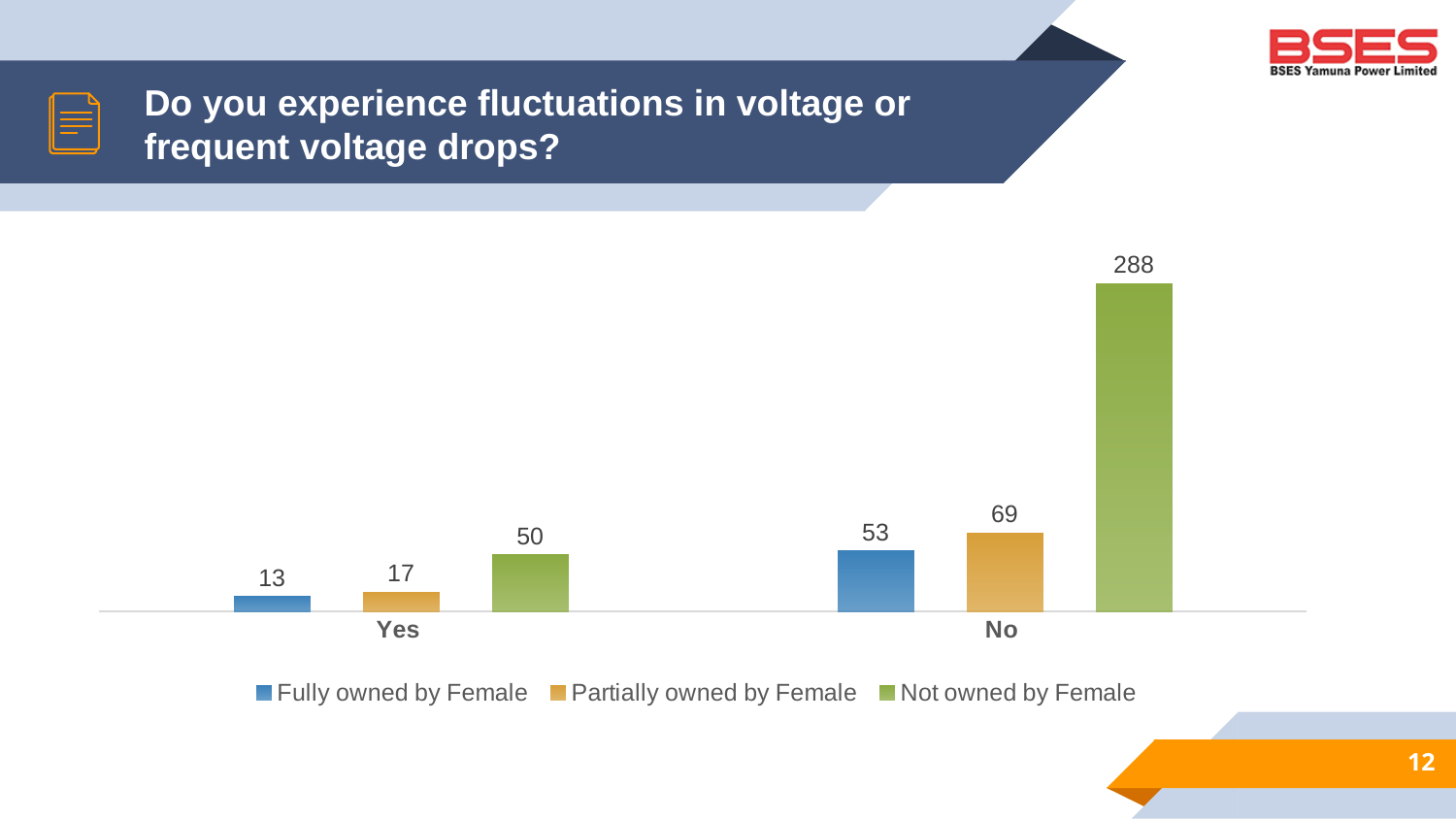
How many categories are shown on the x axis? 2 What is the difference between 'Partially owned by Female' and 'Fully owned by Female' in the 'No' category? 16 What is the value for 'Partially owned by Female' in the 'No' category? 69 What is the value for 'Not owned by Female' in the 'Yes' category? 50 Which series has the highest value in the 'No' category? Not owned by Female What kind of chart is shown on the slide? Bar chart Which is larger: 'Fully owned by Female' for 'No' or 'Not owned by Female' for 'Yes'? Fully owned by Female for No How many series does the legend list? 3 What is the value for 'Not owned by Female' in the 'No' category? 288 What is the value for 'Fully owned by Female' in the 'Yes' category? 13 What is the difference between the 'Not owned by Female' values for 'No' and 'Yes'? 238 Which series has the lowest value in the 'Yes' category? Fully owned by Female